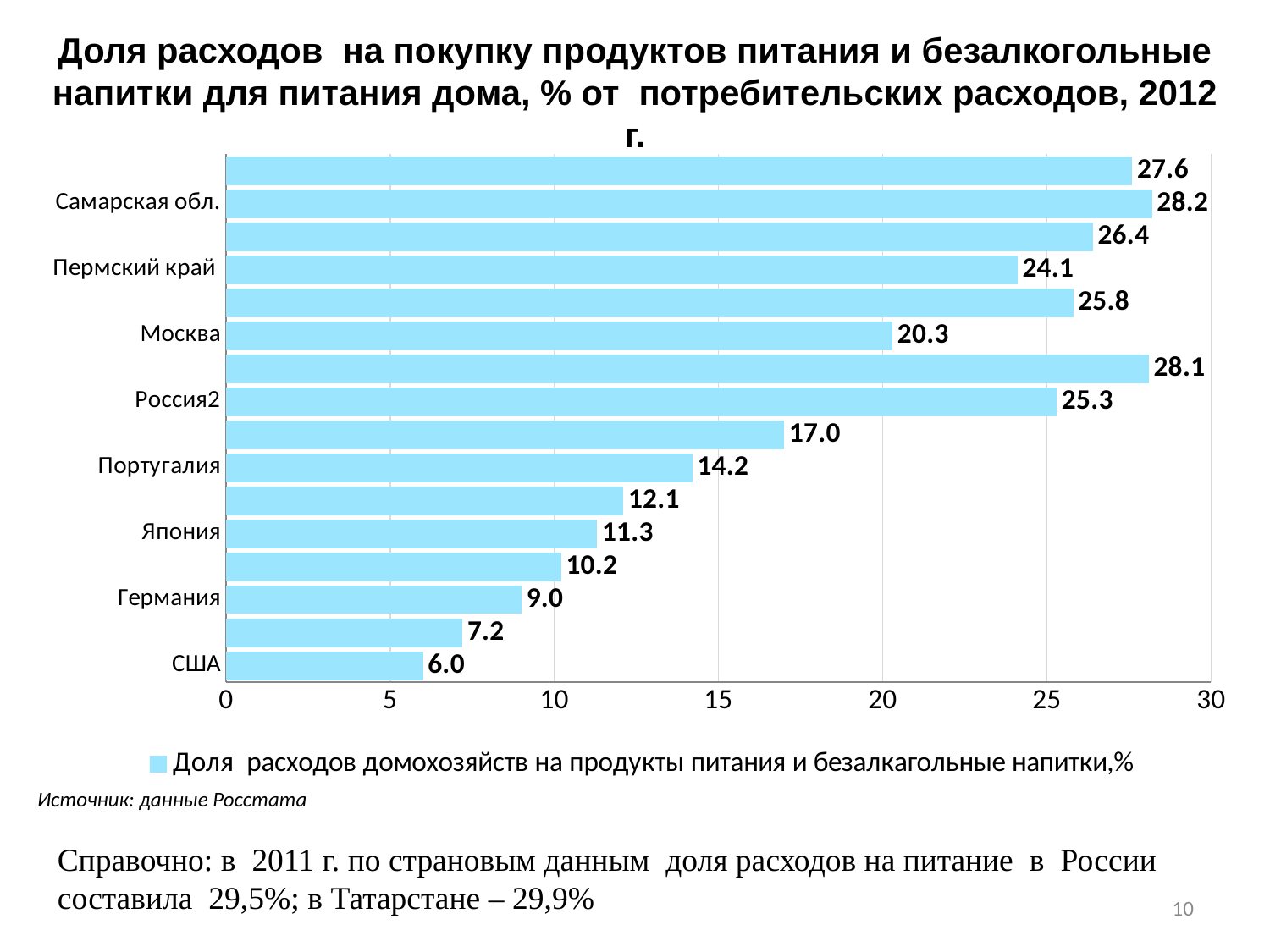
What kind of chart is shown on the slide? bar chart How many bars are plotted on the chart? 16 What is the value for Москва? 20.3 What is the highest value shown on the chart? 28.2 Is the value for Португалия greater or less than 15? less What is the value for Самарская обл.? 28.2 What is the value for Россия2? 25.3 What is the value for Япония? 11.3 What is the difference between the values for Португалия and Германия? 5.2 Which is larger, the value for Пермский край or the value for Россия2? Россия2 What is the difference between the values for Самарская обл. and США? 22.2 Which labeled category has the lowest value? США